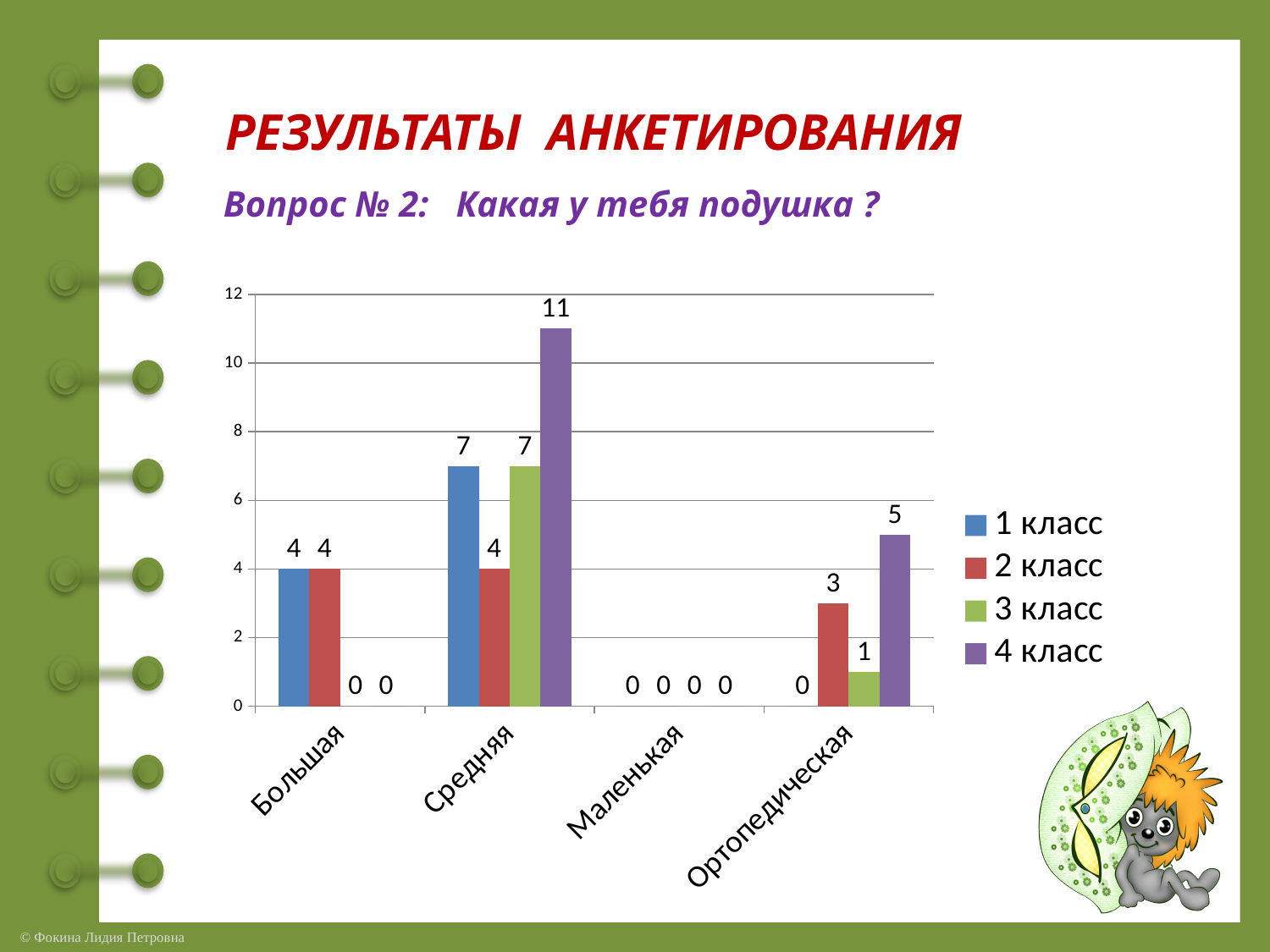
Which category has the highest value for 4 класс? Средняя What is the difference between the 4 класс value and the 2 класс value in the Средняя category? 7 What is the value for 1 класс in the Большая category? 4 What kind of chart is shown on the slide? bar chart Which legend entry is shown in purple? 4 класс How many series does the legend list? 4 How many categories are shown on the x axis? 4 Which category has the lowest value for 2 класс? Маленькая What is the value for 4 класс in the Средняя category? 11 What is the value for 3 класс in the Ортопедическая category? 1 What is the value for 2 класс in the Ортопедическая category? 3 Which is larger in the Ортопедическая category: the value for 2 класс or the value for 4 класс? 4 класс